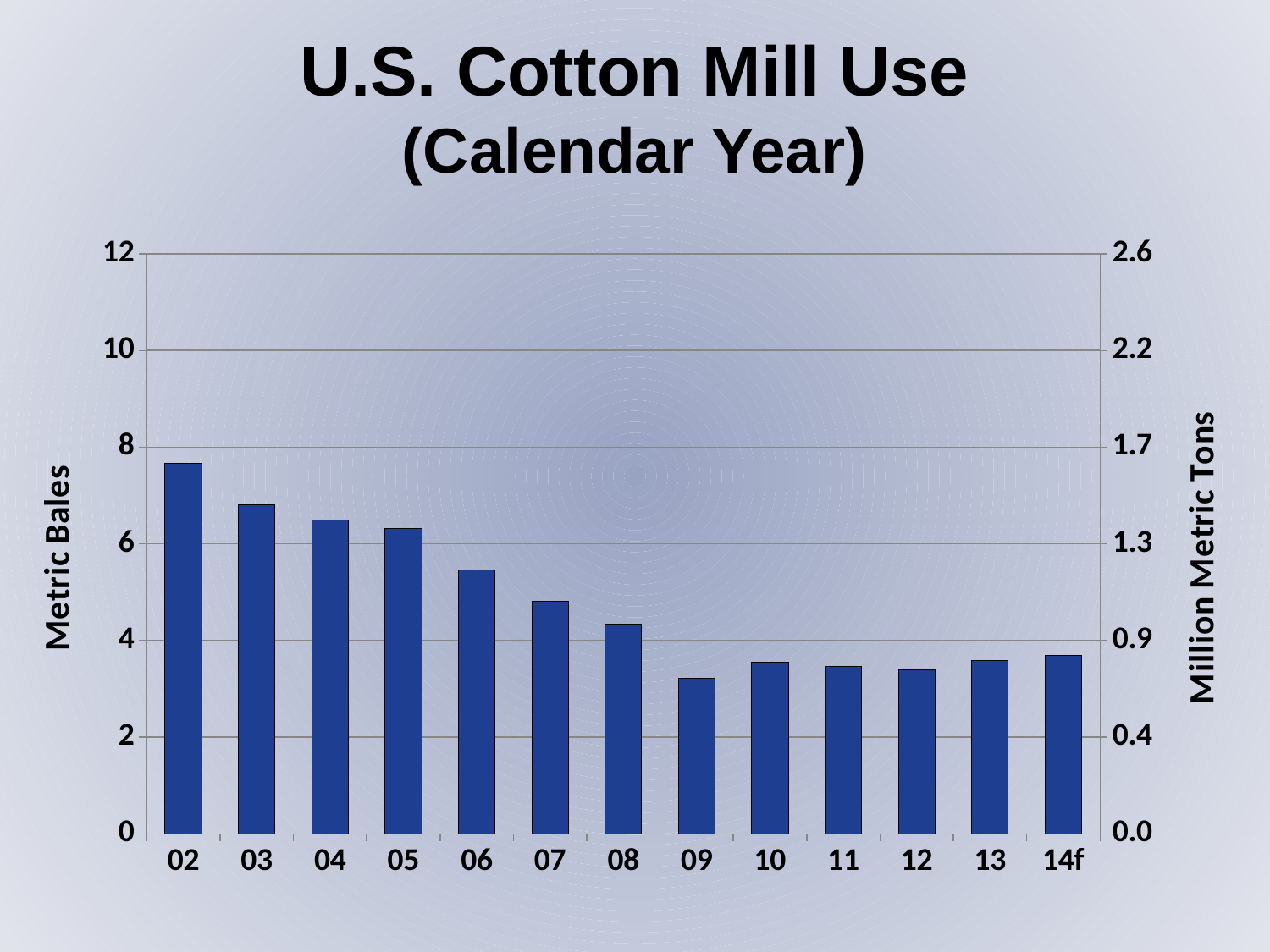
Do the values generally rise or fall from 02 to 14f? fall Which year has the lowest U.S. cotton mill use? 09 Is the value for 09 greater or less than 4 on the Metric Bales axis? less What kind of chart is shown on the slide? bar chart Which is larger, the value for 10 or the value for 06? 06 Is the value for 02 greater or less than 6 on the Metric Bales axis? greater What is the label on the right-hand vertical axis? Million Metric Tons Is the value for 06 greater or less than 4 on the Metric Bales axis? greater Which year has the highest U.S. cotton mill use? 02 How many years (bars) are plotted on the chart? 13 Which is larger, the value for 03 or the value for 08? 03